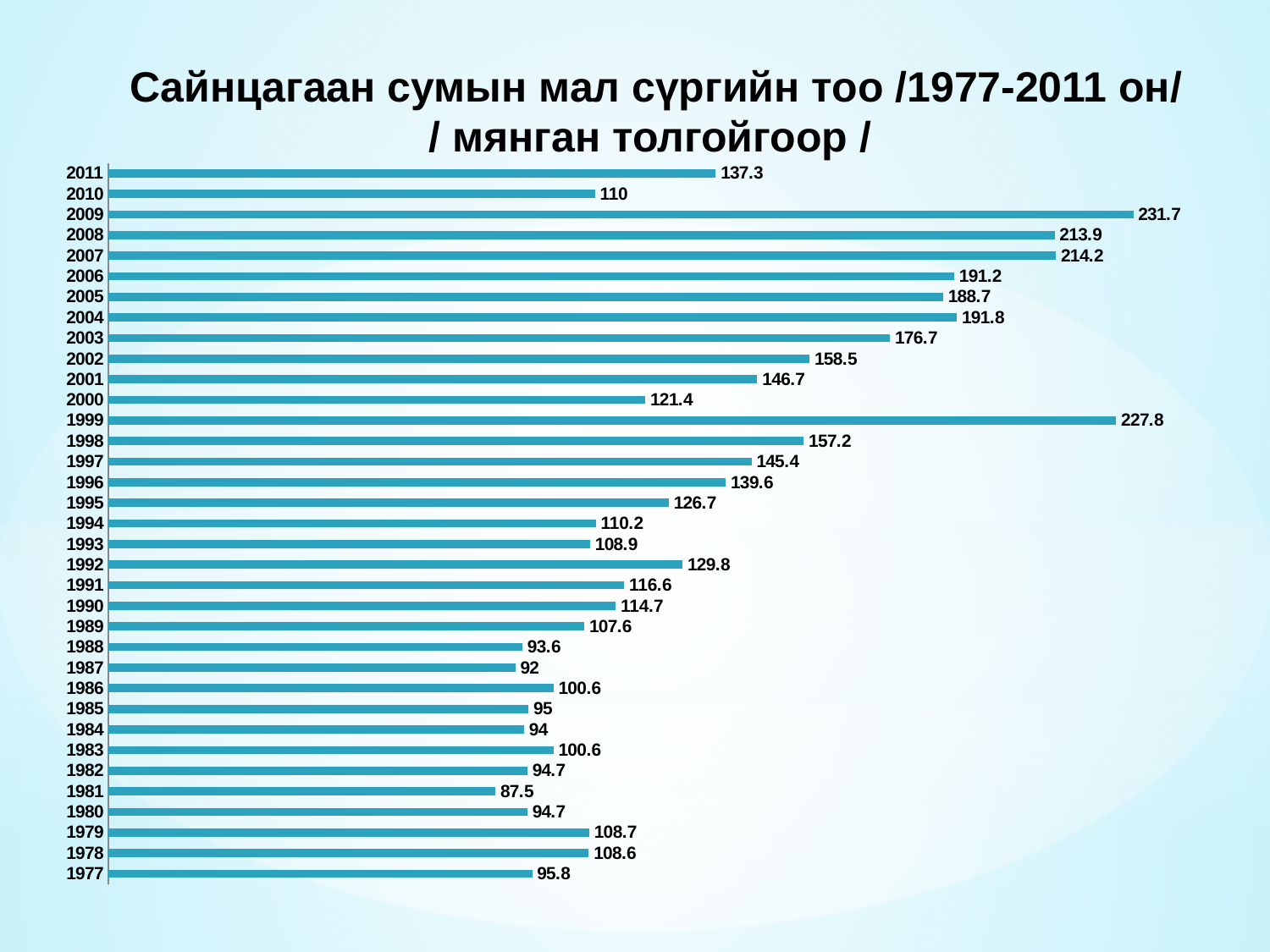
How many years are shown in the chart? 35 What is the value for 2009? 231.7 What kind of chart is shown on the slide? Bar chart What is the difference between the values for 2009 and 2010? 121.7 What is the value for 1981? 87.5 What is the value for 2000? 121.4 What is the difference between the values for 2011 and 2010? 27.3 Which year has the highest value? 2009 Which year has the lowest value? 1981 Which is larger, the value for 1999 or the value for 2008? 1999 Which is larger, the value for 1992 or the value for 1995? 1992 What is the title of the chart? Сайнцагаан сумын мал сүргийн тоо /1977-2011 он/ / мянган толгойгоор /